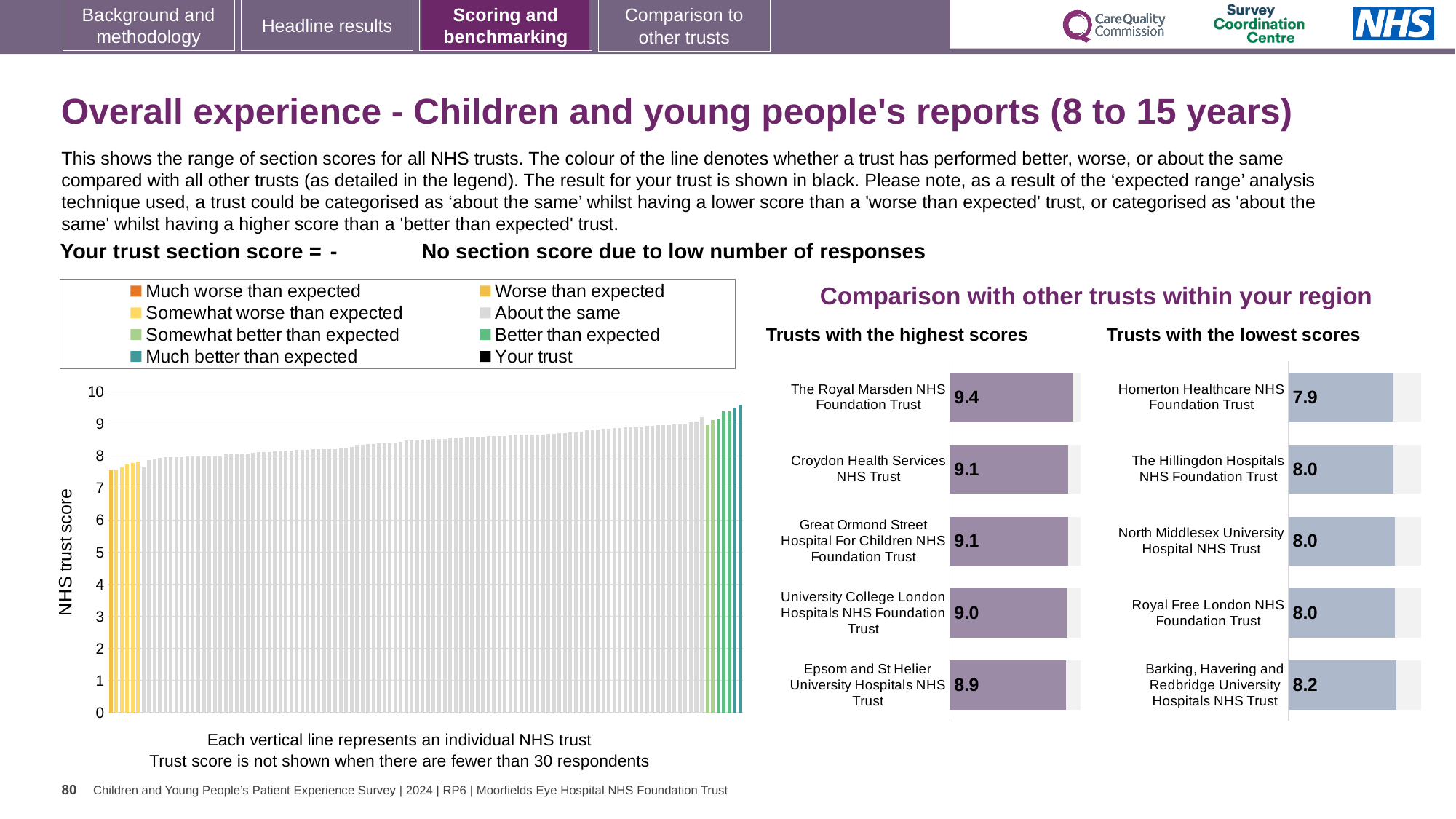
In the 'Trusts with the lowest scores' chart, which trust has the highest score? Barking, Havering and Redbridge University Hospitals NHS Trust In the large chart on the left showing all NHS trusts, is the value of the rightmost bar greater or less than 9? greater In the 'Trusts with the highest scores' chart, which trust has the lowest score? Epsom and St Helier University Hospitals NHS Trust In the 'Trusts with the lowest scores' chart, what is the score for Homerton Healthcare NHS Foundation Trust? 7.9 In the large chart on the left showing all NHS trusts, do the bar values rise or fall from left to right? rise How many trusts are shown in the 'Trusts with the lowest scores' chart? 5 In the 'Trusts with the lowest scores' chart, what is the difference between the scores of Barking, Havering and Redbridge University Hospitals NHS Trust and Homerton Healthcare NHS Foundation Trust? 0.3 Which has the larger score: Croydon Health Services NHS Trust in the highest scores chart or Royal Free London NHS Foundation Trust in the lowest scores chart? Croydon Health Services NHS Trust How many entries does the legend above the large chart on the left list? 8 In the large chart on the left showing all NHS trusts, is the value of the leftmost bar greater or less than 8? less In the 'Trusts with the highest scores' chart, what is the difference between the scores of The Royal Marsden NHS Foundation Trust and Epsom and St Helier University Hospitals NHS Trust? 0.5 In the 'Trusts with the highest scores' chart, what is the score for The Royal Marsden NHS Foundation Trust? 9.4